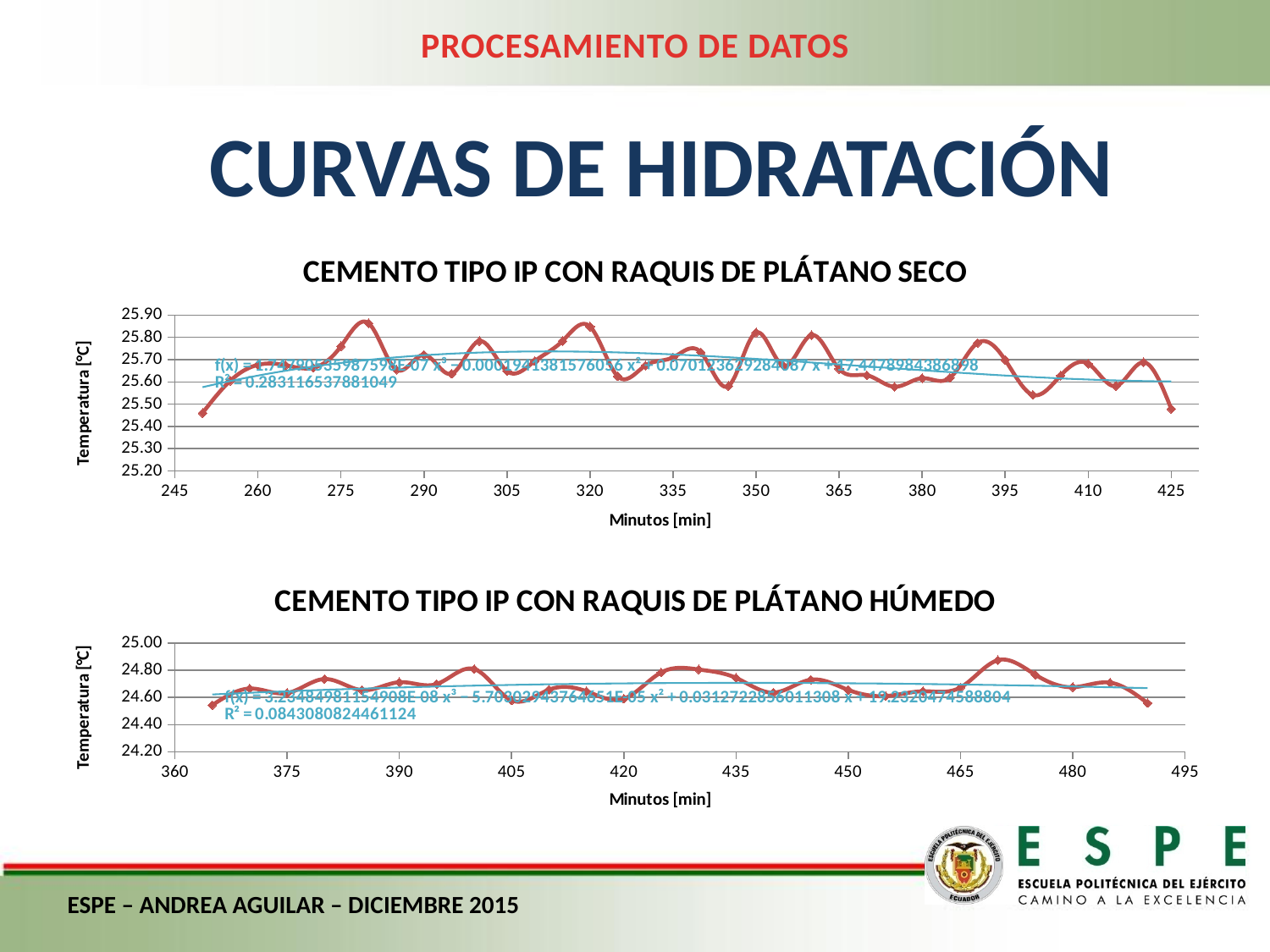
In the bottom chart (PLÁTANO HÚMEDO), is the temperature at the last point near 490 minutes greater or less than 24.80? less In the top chart (PLÁTANO SECO), is the temperature at the first point near 250 minutes greater or less than 25.60? less What kind of chart is the bottom chart titled 'CEMENTO TIPO IP CON RAQUIS DE PLÁTANO HÚMEDO'? Line chart In the bottom chart (PLÁTANO HÚMEDO), is the temperature at about 400 minutes greater or less than 24.60? greater What kind of chart is the top chart titled 'CEMENTO TIPO IP CON RAQUIS DE PLÁTANO SECO'? Line chart What is the x-axis label of the top chart (PLÁTANO SECO)? Minutos [min] What R² value is printed on the bottom chart (PLÁTANO HÚMEDO)? 0.0843080824461124 In the top chart (PLÁTANO SECO), does the blue fitted curve rise or fall between 380 and 425 minutes? fall